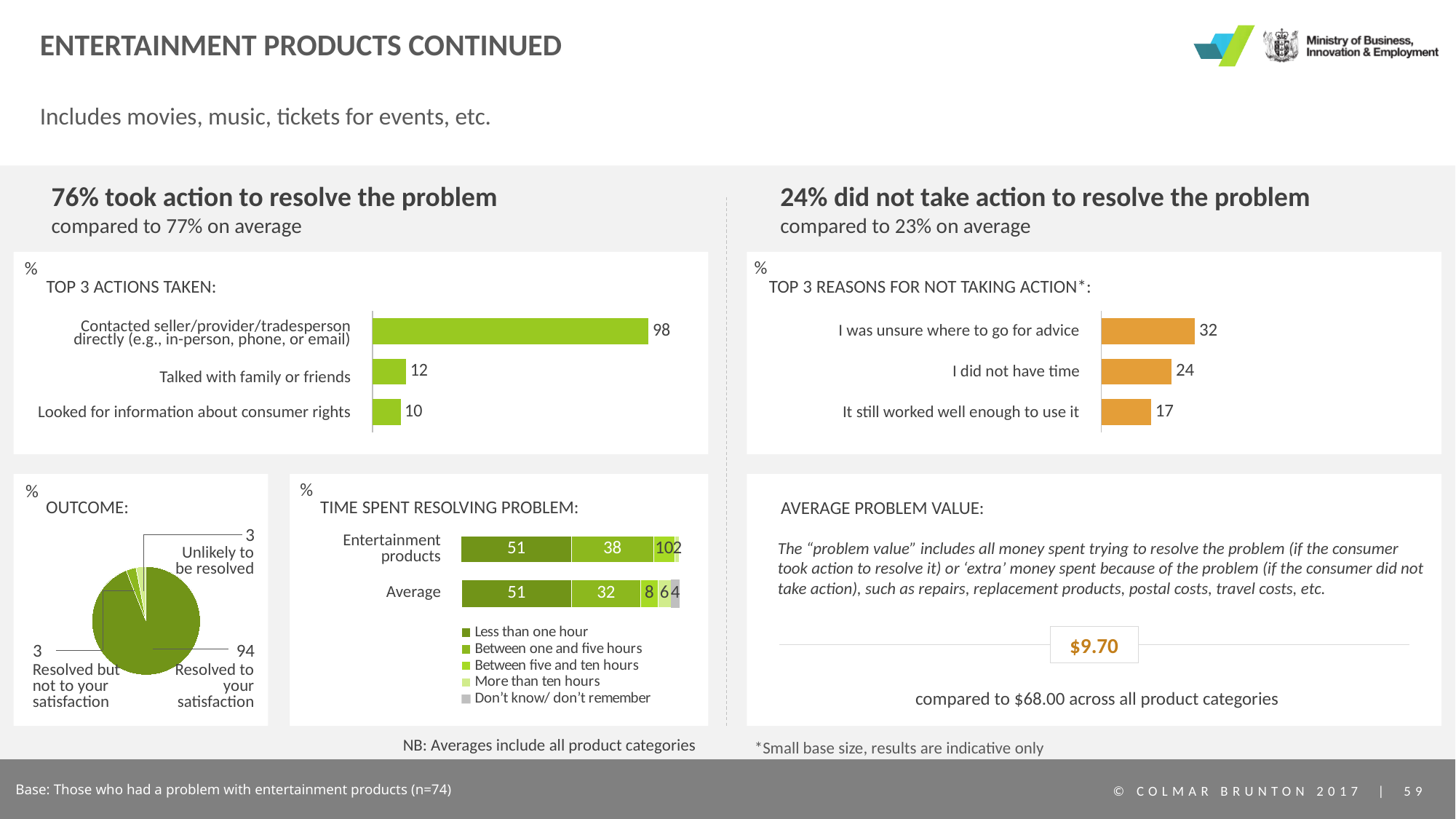
How many slices does the OUTCOME pie chart have? 3 In the TOP 3 ACTIONS TAKEN chart, what is the value for 'Contacted seller/provider/tradesperson directly'? 98 In the TOP 3 ACTIONS TAKEN chart, what is the difference between 'Talked with family or friends' and 'Looked for information about consumer rights'? 2 How many series does the legend of the TIME SPENT RESOLVING PROBLEM chart list? 5 In the OUTCOME pie chart, what is the value for 'Resolved to your satisfaction'? 94 In the TOP 3 REASONS FOR NOT TAKING ACTION chart, which reason has the highest value? I was unsure where to go for advice In the TOP 3 ACTIONS TAKEN chart, which action has the lowest value? Looked for information about consumer rights In the TIME SPENT RESOLVING PROBLEM chart, which is larger for 'Between one and five hours': Entertainment products or Average? Entertainment products In the TOP 3 REASONS FOR NOT TAKING ACTION chart, what is the difference between 'I was unsure where to go for advice' and 'It still worked well enough to use it'? 15 In the TIME SPENT RESOLVING PROBLEM chart, what is the 'Less than one hour' value for Entertainment products? 51 In the TOP 3 REASONS FOR NOT TAKING ACTION chart, what is the value for 'I did not have time'? 24 What kind of chart is the OUTCOME chart? Pie chart